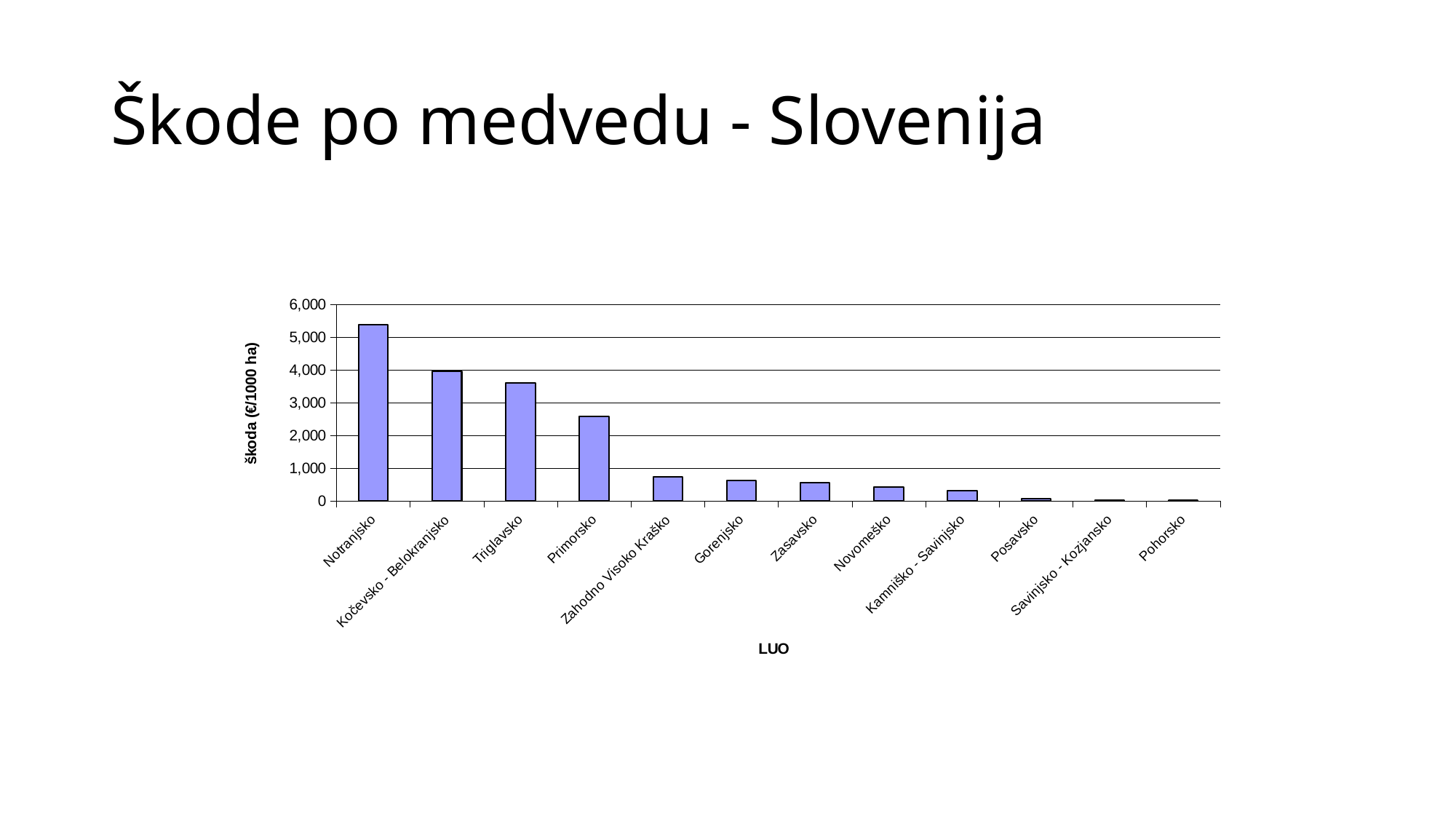
Which has a larger value, Zahodno Visoko Kraško or Novomeško? Zahodno Visoko Kraško Is the value for Triglavsko greater or less than 3,000? greater Which LUO has the highest škoda value in the chart? Notranjsko Is the value for Zahodno Visoko Kraško greater or less than 1,000? less Is the value for Kamniško - Savinjsko greater or less than 1,000? less Which has a larger value, Triglavsko or Primorsko? Triglavsko How many categories (LUO) are shown on the x axis of the chart? 12 What kind of chart is shown on the slide? bar chart What is the label of the y axis of the chart? škoda (€/1000 ha) Do the values rise or fall moving from left to right along the x axis? fall